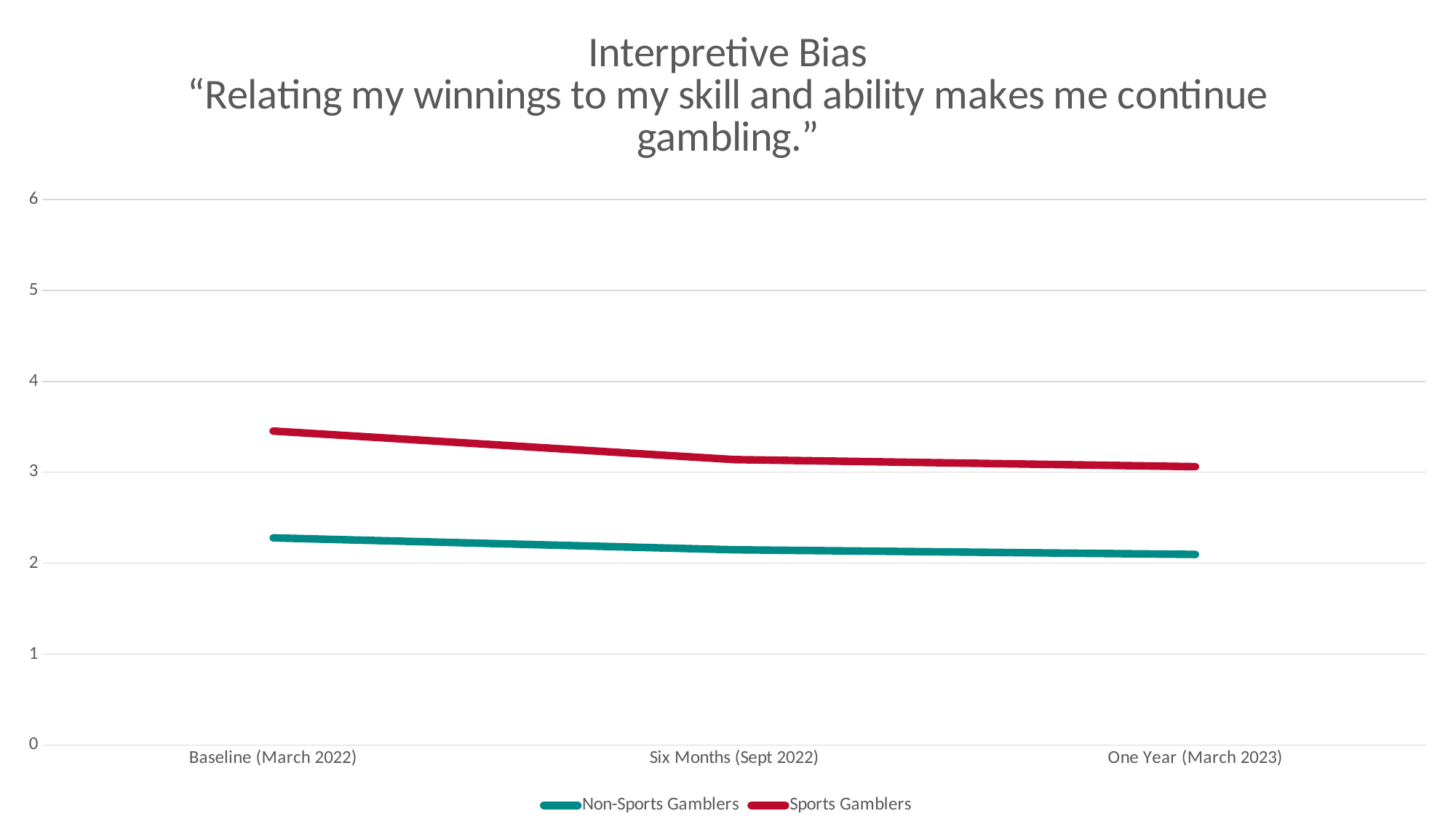
At Baseline (March 2022), which series has the higher value, Sports Gamblers or Non-Sports Gamblers? Sports Gamblers What kind of chart is shown on the slide? line chart Is the value for Non-Sports Gamblers at One Year (March 2023) greater or less than 3? less Does the Sports Gamblers line rise or fall from Baseline (March 2022) to One Year (March 2023)? fall Is the value for Sports Gamblers at Baseline (March 2022) greater or less than 4? less How many time points are plotted along the x axis? 3 How many series does the legend list? 2 Is the value for Non-Sports Gamblers at Baseline (March 2022) greater or less than 2? greater Which series is drawn in red? Sports Gamblers Does the Non-Sports Gamblers line rise or fall from Baseline (March 2022) to One Year (March 2023)? fall